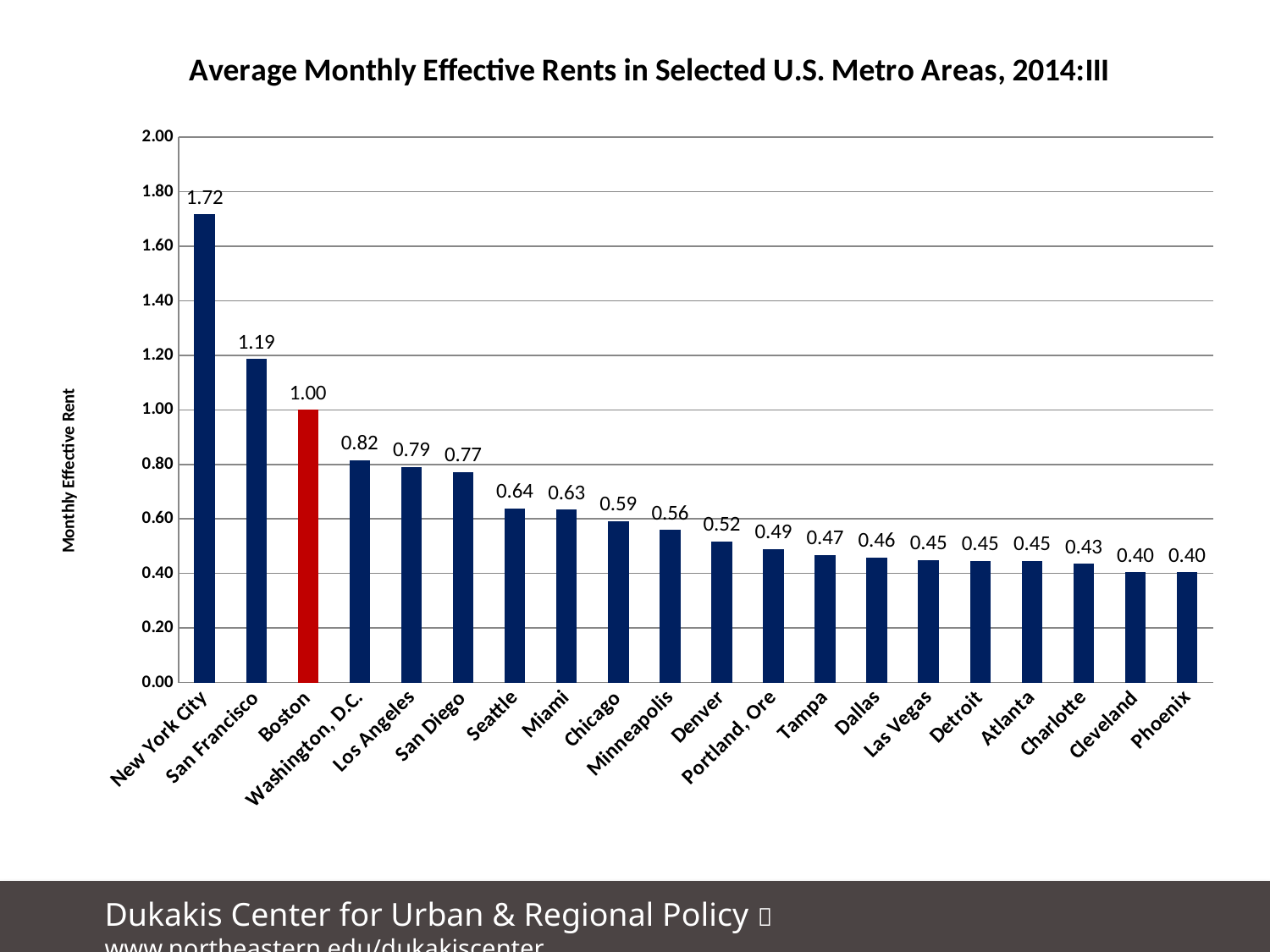
Do the values rise or fall from left to right along the x axis? fall What is the difference between the values for New York City and Boston? 0.72 What is the difference between the values for Los Angeles and San Diego? 0.02 What kind of chart is this? bar chart Which metro area has the highest value? New York City How many metro areas are shown on the chart? 20 Which has a larger value, Washington, D.C. or Miami? Washington, D.C. What is the value for San Francisco? 1.19 Which bar is coloured red rather than dark blue? Boston What is the value for Seattle? 0.64 What is the value for Boston? 1.00 Is the value for Chicago greater or less than 0.60? less